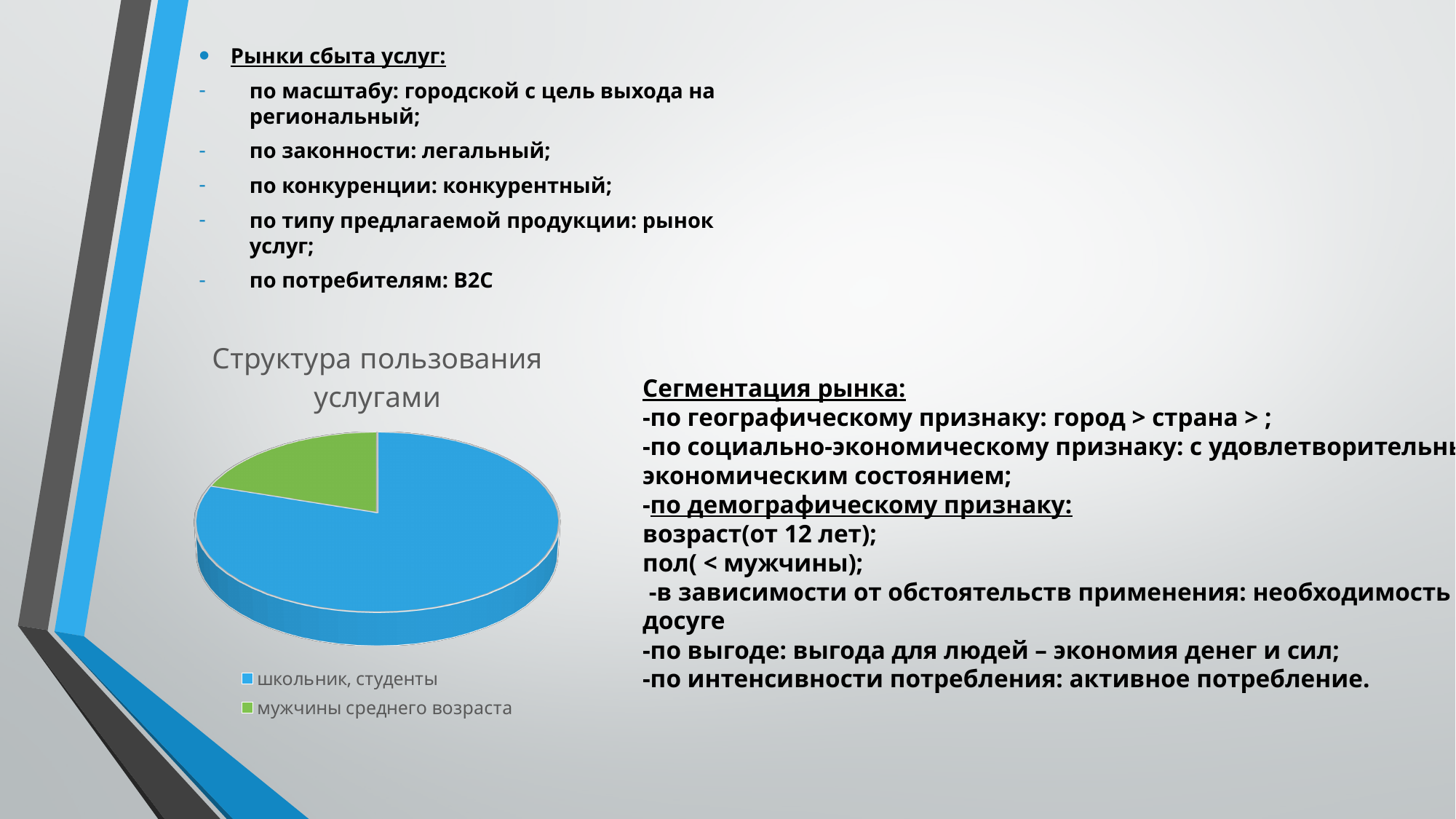
Does the slice for "мужчины среднего возраста" take up more or less than half of the pie? less What kind of chart is shown on the slide? pie chart Which slice is larger: "школьник, студенты" or "мужчины среднего возраста"? школьник, студенты Which category has the smallest slice in the pie chart? мужчины среднего возраста How many entries does the legend of the pie chart list? 2 What colour is the slice for "мужчины среднего возраста" in the pie chart? green How many slices does the pie chart have? 2 Does the slice for "школьник, студенты" take up more or less than half of the pie? more What is the title of the pie chart? Структура пользования услугами Which category has the largest slice in the pie chart? школьник, студенты